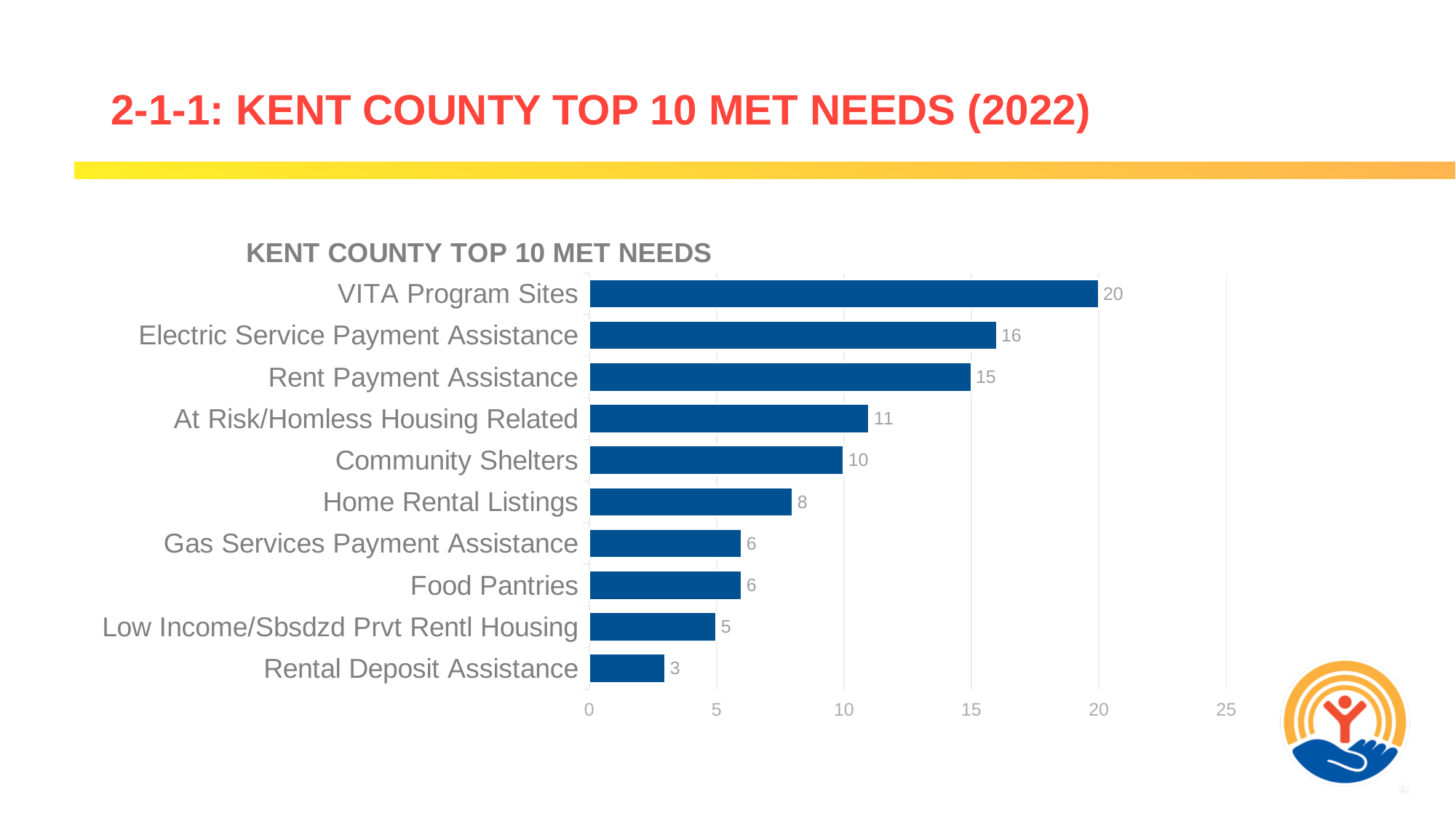
What is the value for Rental Deposit Assistance? 3 What is the value for VITA Program Sites? 20 What kind of chart is shown on the slide? Bar chart Which category has the highest value? VITA Program Sites Is the value for Electric Service Payment Assistance greater or less than 15? greater Which category has the lowest value? Rental Deposit Assistance What is the title of the chart? KENT COUNTY TOP 10 MET NEEDS What is the value for Community Shelters? 10 What is the difference between Electric Service Payment Assistance and Rent Payment Assistance? 1 Which is larger, At Risk/Homless Housing Related or Community Shelters? At Risk/Homless Housing Related How many categories are shown in the chart? 10 What is the difference between VITA Program Sites and Home Rental Listings? 12